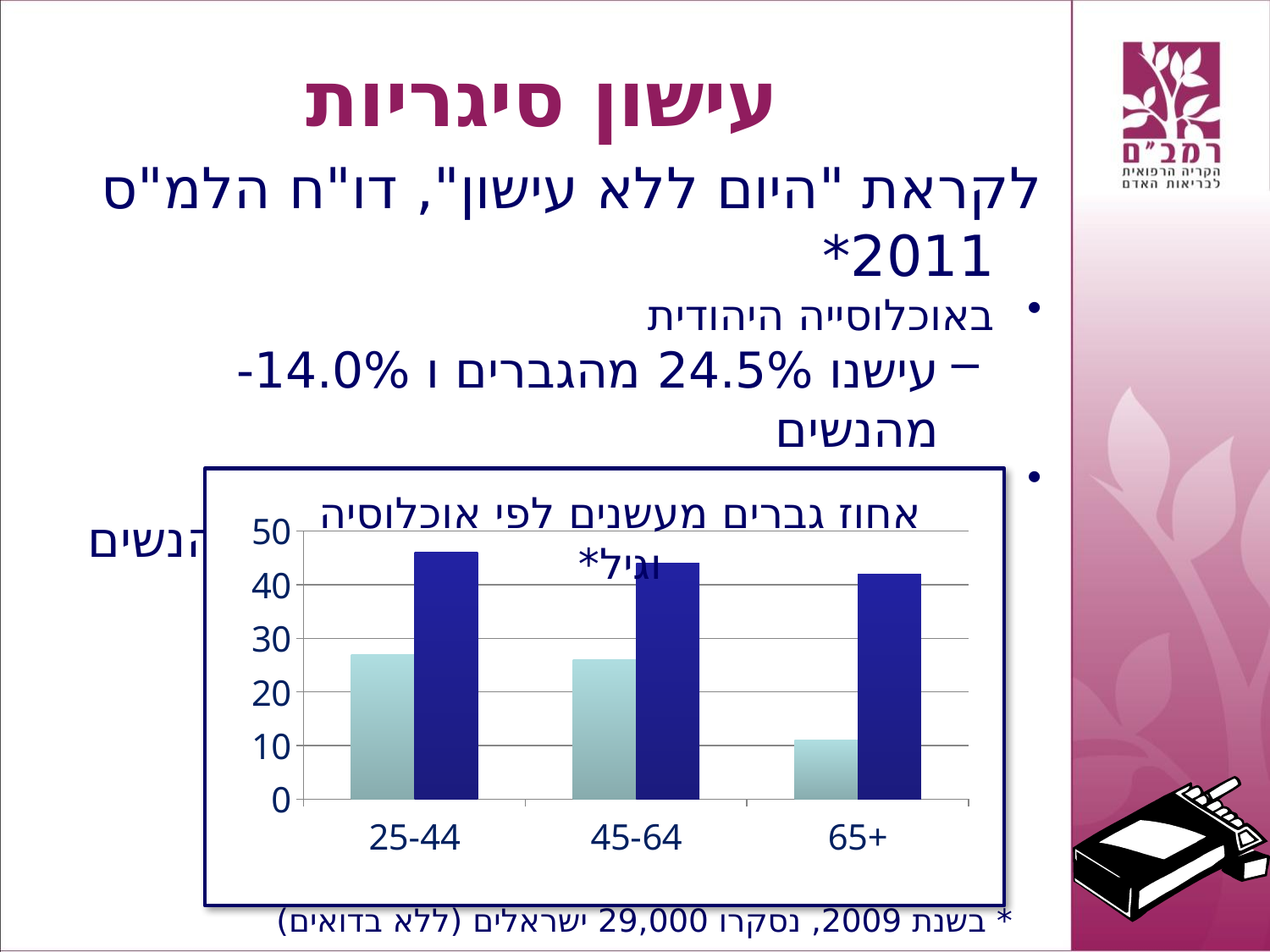
Do the dark blue bars rise or fall as the age groups increase from 25-44 to 65+? fall Is the value of the light teal bar for the 65+ age group greater or less than 20? less Which age group has the highest dark blue bar? 25-44 What kind of chart is shown on the slide? bar chart Is the value of the light teal bar for the 25-44 age group greater or less than 20? greater Which age group has the lowest light teal bar? 65+ How many bars are plotted for each age group in the chart? 2 For the 45-64 age group, which bar is larger, the light teal one or the dark blue one? the dark blue one Is the value of the dark blue bar for the 25-44 age group greater or less than 40? greater How many age-group categories are shown on the x axis of the chart? 3 What is the highest value shown on the chart's y axis? 50